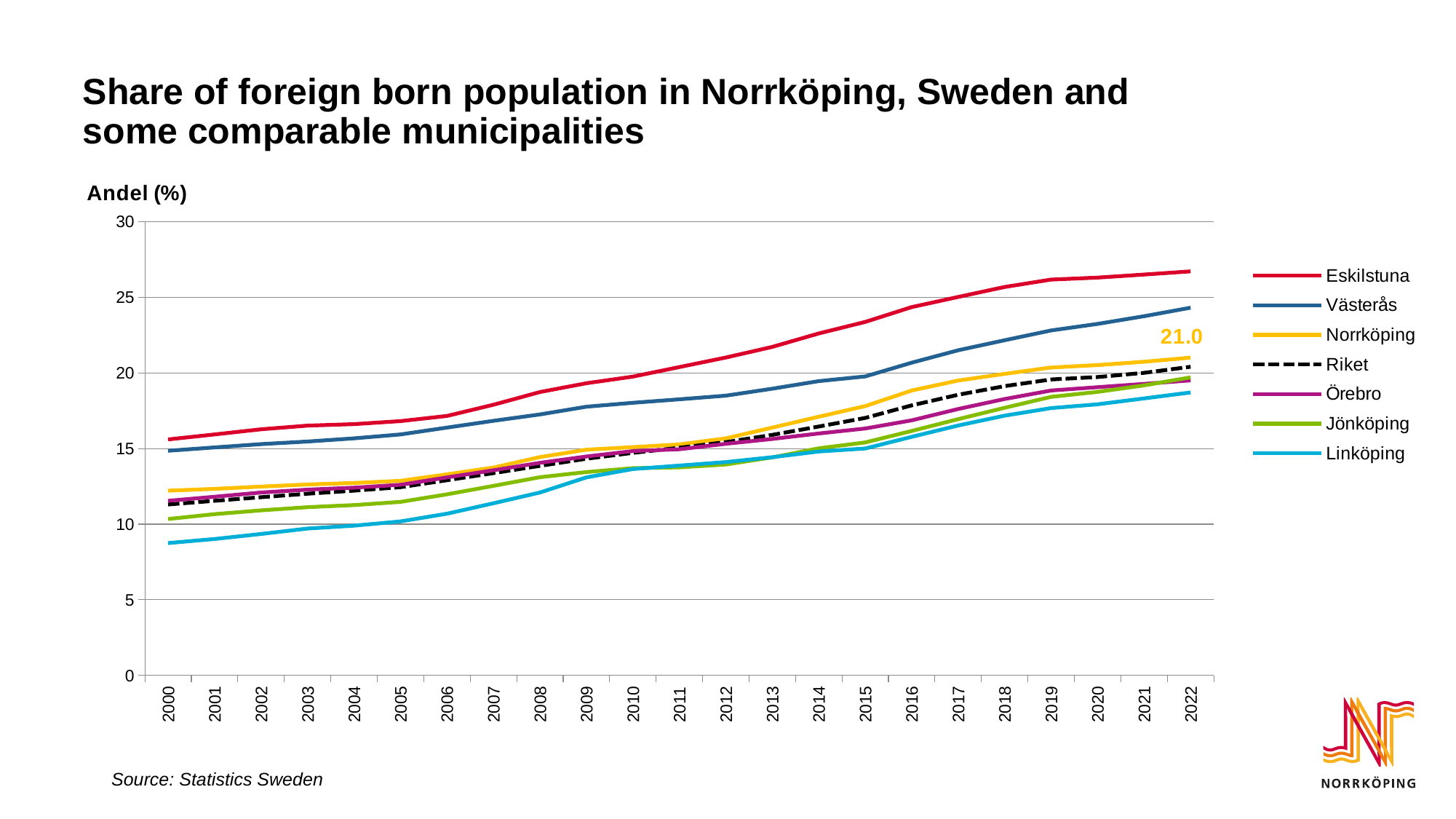
Do the values for Eskilstuna rise or fall from 2000 to 2022? rise Which series has the lowest value in 2022? Linköping How many series does the legend list? 7 Is the value for Linköping in 2000 greater or less than 10? less In 2022, which is larger: Eskilstuna or Västerås? Eskilstuna What is the value for Norrköping in 2022? 21.0 Is the value for Eskilstuna in 2022 greater or less than 25? greater How many years are plotted along the x axis? 23 Which series has the lowest value in 2000? Linköping What kind of chart is shown on the slide? line chart Which series has the highest value in 2022? Eskilstuna Which series is drawn as a dashed line? Riket